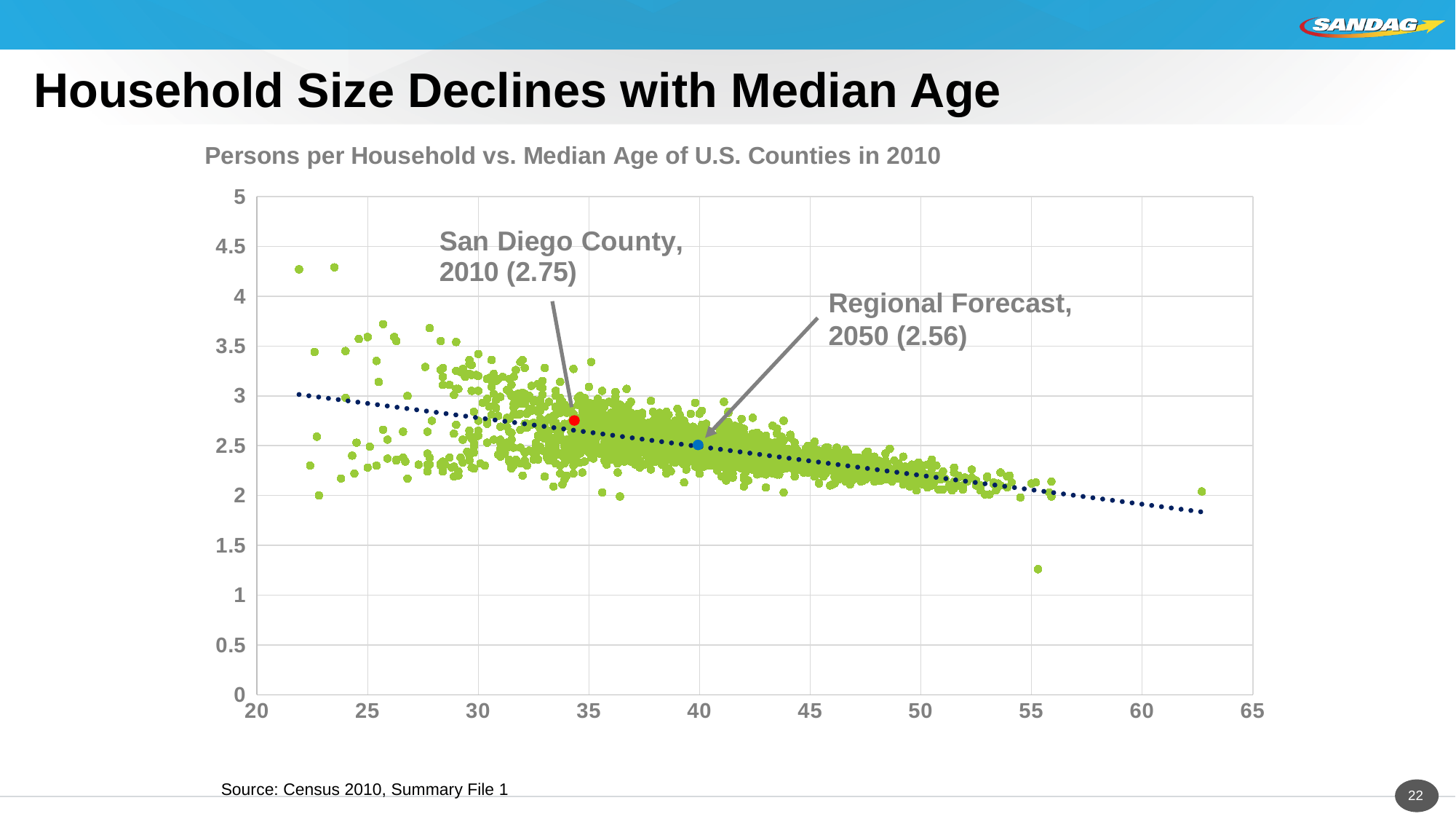
As median age increases along the x axis, does the dotted trend line rise or fall? fall What is the maximum value shown on the y axis? 5 Is the persons-per-household value of the lowest outlier point near median age 55 greater or less than 1.5? less Which is larger, the San Diego County 2010 value or the Regional Forecast 2050 value? San Diego County, 2010 Are the two highest points near median age 22-23 greater or less than 4 persons per household? greater What is the difference between the San Diego County 2010 value and the Regional Forecast 2050 value? 0.19 What is the source cited for the chart data? Census 2010, Summary File 1 What is the title of the chart? Persons per Household vs. Median Age of U.S. Counties in 2010 What is the persons-per-household value labelled for San Diego County in 2010? 2.75 What kind of chart is shown on the slide? scatter chart What is the persons-per-household value labelled for the Regional Forecast in 2050? 2.56